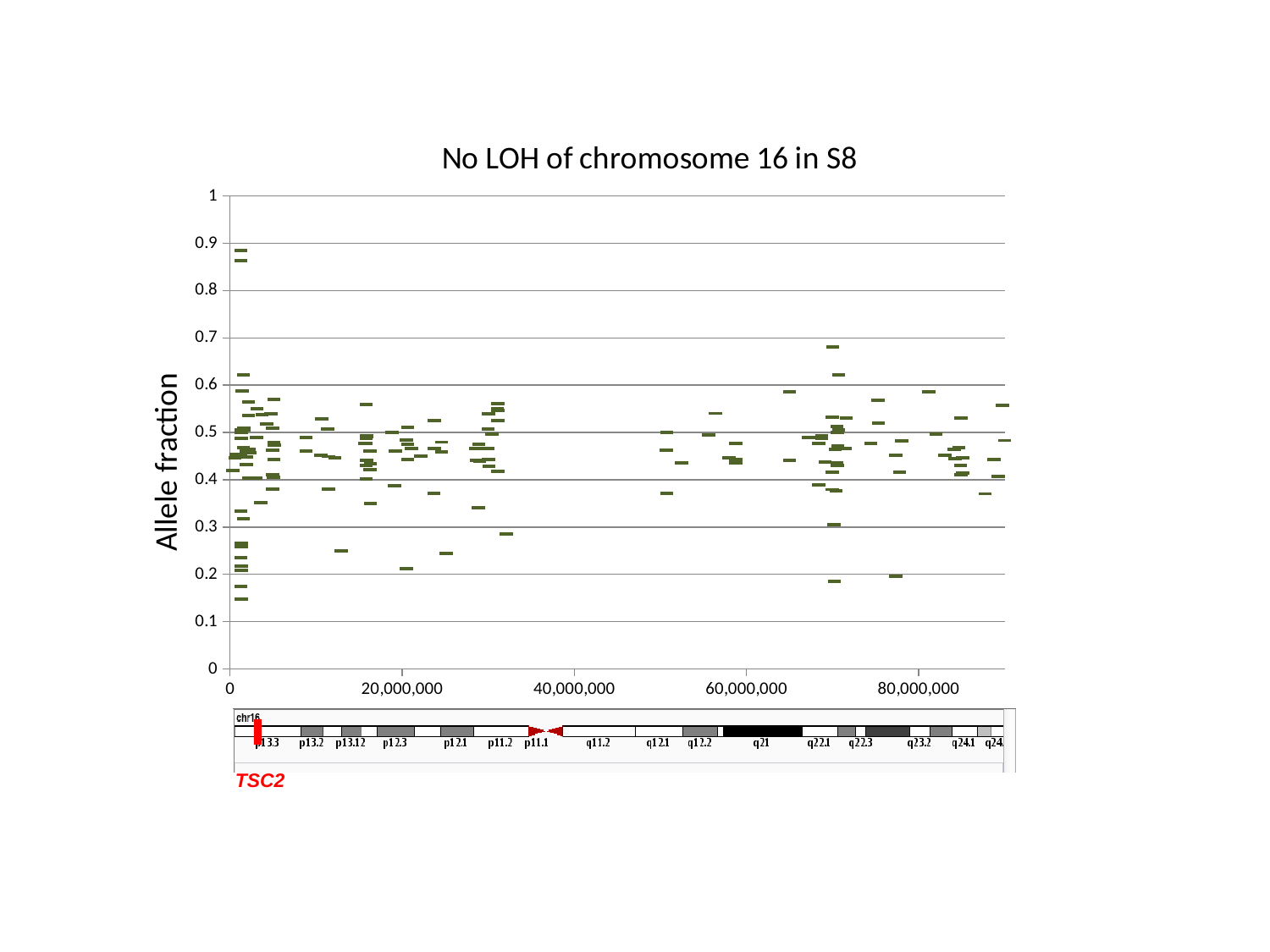
What is the label on the y axis of the chart? Allele fraction Is the lowest point plotted near position 70,000,000 greater or less than 0.2? less Is the lowest plotted allele fraction on the chart greater or less than 0.2? less Is the highest point plotted near position 70,000,000 greater or less than 0.6? greater How many points are plotted between 35,000,000 and 48,000,000 on the x axis? 0 What is the title of the chart? No LOH of chromosome 16 in S8 What kind of chart is shown on the slide? scatter plot